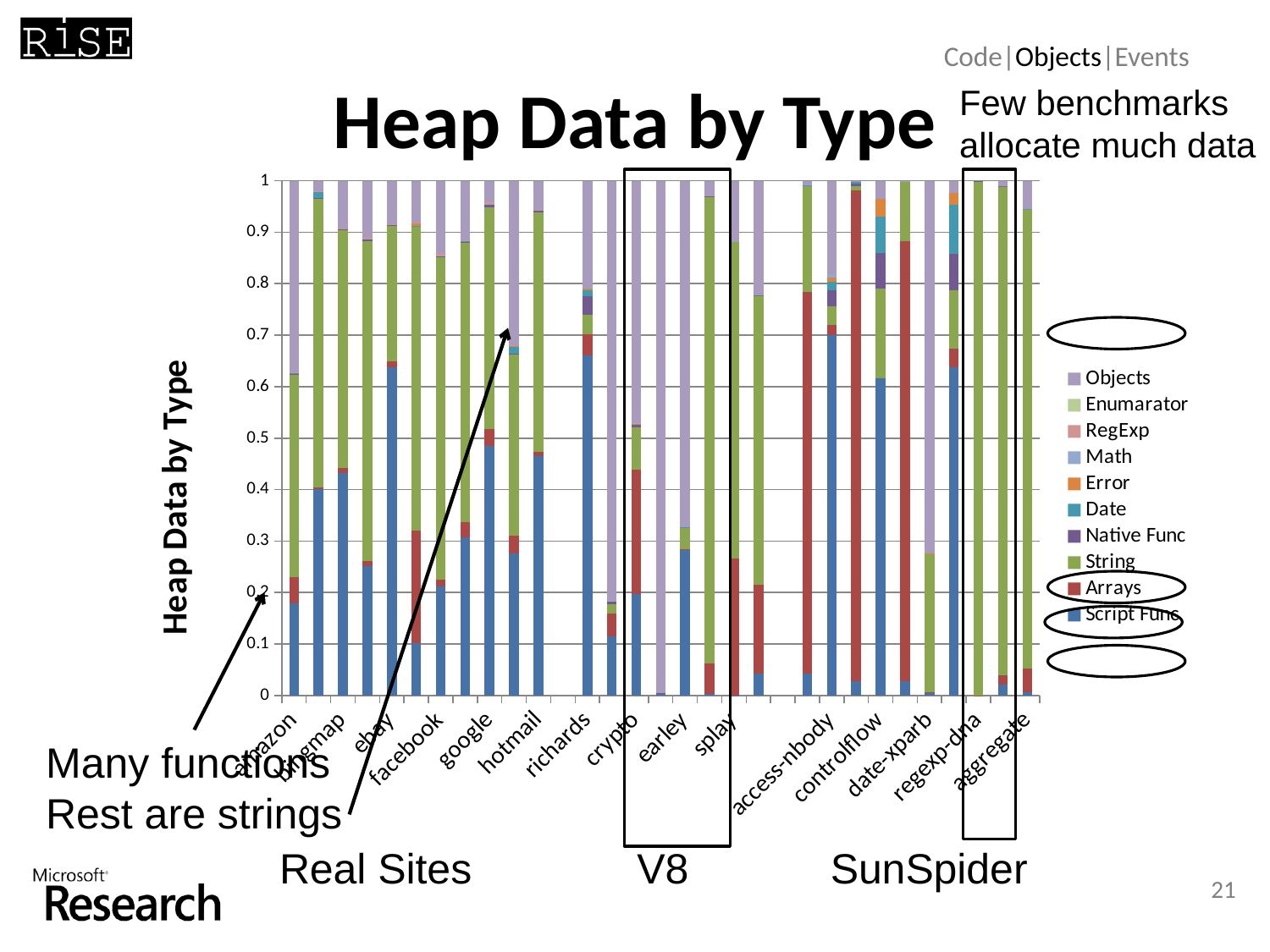
Is the Script Func value for amazon greater or less than 0.3? less Is the Script Func value for crypto greater or less than 0.3? less How many series does the legend of the Heap Data by Type chart list? 10 What is the title of the chart? Heap Data by Type Which series is listed last in the chart legend? Script Func Which has the larger Script Func value, richards or earley? richards Which has the larger Script Func value, ebay or amazon? ebay What kind of chart is shown on the slide? Stacked bar chart Is the Script Func value for richards greater or less than 0.5? greater